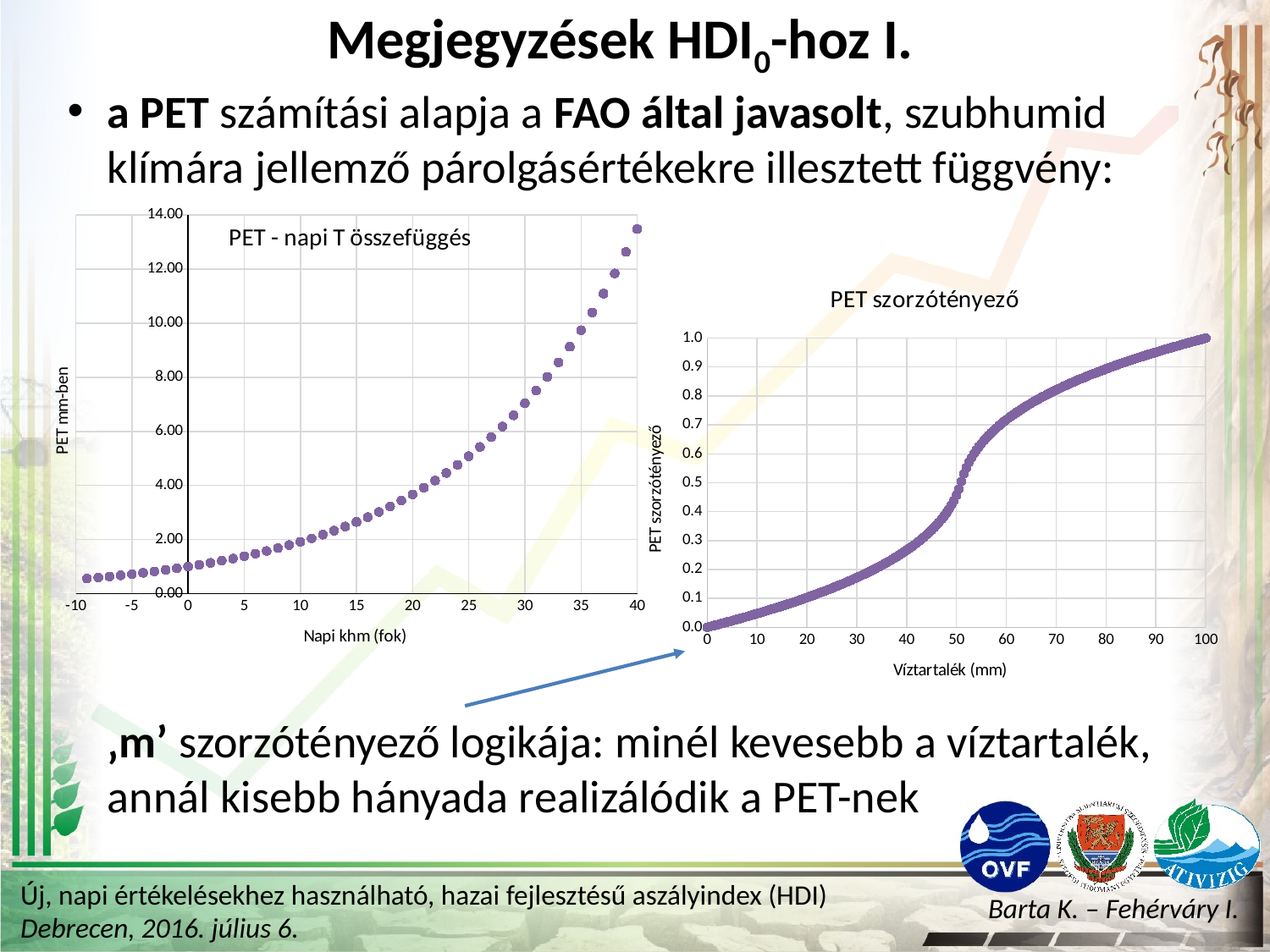
In the right chart 'PET szorzótényező', what is the value of the multiplier at 100 mm Víztartalék? 1.0 In the left chart 'PET - napi T összefüggés', is the PET value at 40 fok greater or less than 12.00? greater In the right chart 'PET szorzótényező', is the value at 70 mm Víztartalék greater or less than 0.7? greater What kind of chart is the left chart titled 'PET - napi T összefüggés'? scatter chart In the right chart 'PET szorzótényező', is the value at 30 mm Víztartalék greater or less than 0.3? less In the right chart 'PET szorzótényező', do the values rise or fall as Víztartalék increases along the x axis? rise In the left chart 'PET - napi T összefüggés', do the PET values rise or fall as the daily temperature increases along the x axis? rise What is the x-axis label of the right chart 'PET szorzótényező'? Víztartalék (mm) What kind of chart is the right chart titled 'PET szorzótényező'? scatter chart What is the x-axis label of the left chart 'PET - napi T összefüggés'? Napi khm (fok)